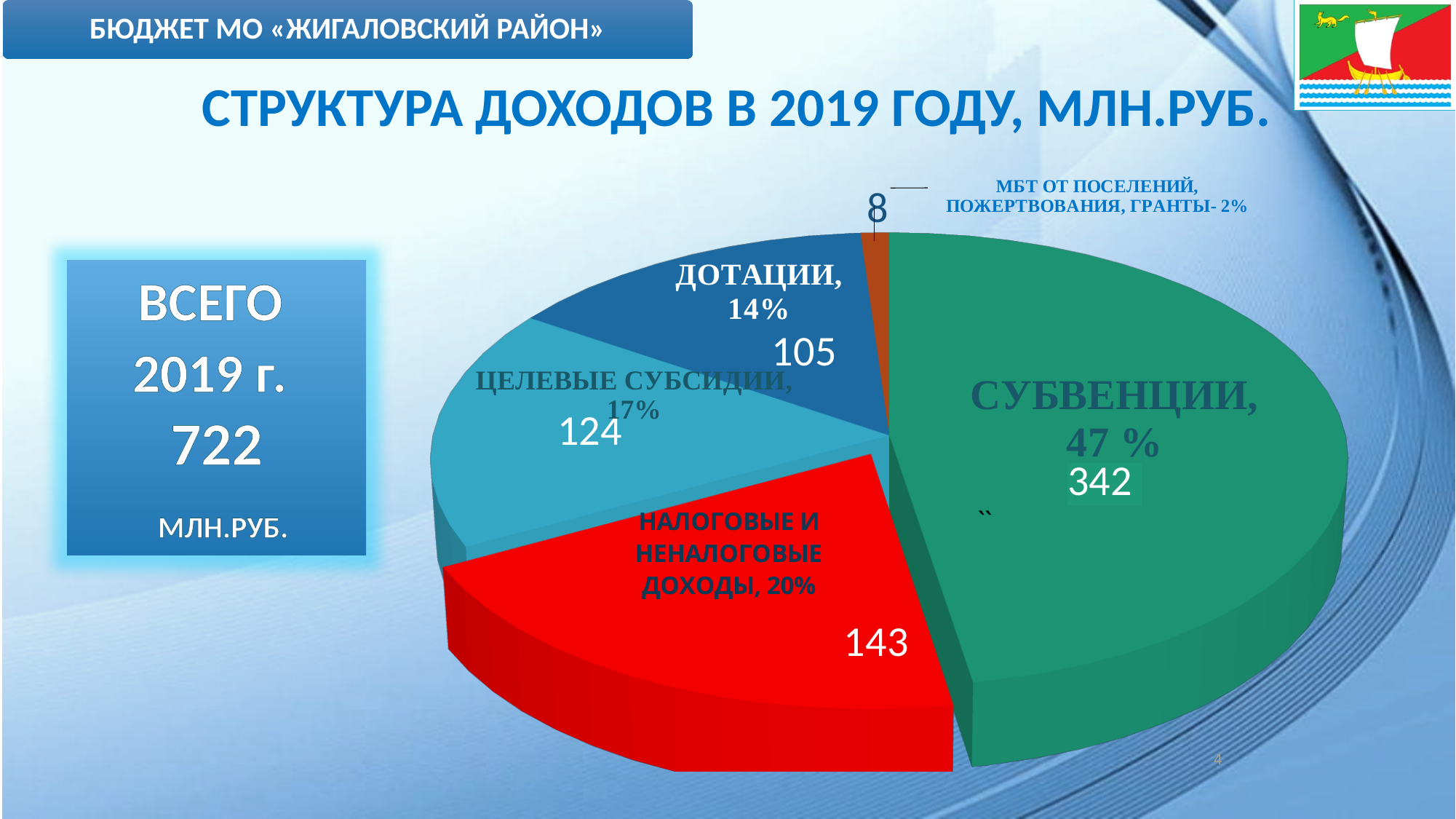
Which category has the smallest slice in the pie chart? МБТ ОТ ПОСЕЛЕНИЙ, ПОЖЕРТВОВАНИЯ, ГРАНТЫ What kind of chart is shown on the slide? pie chart What share of the pie does «СУБВЕНЦИИ» represent? 47 % Which category has the largest slice in the pie chart? СУБВЕНЦИИ What is the value for «СУБВЕНЦИИ» in the pie chart? 342 What is the difference between the values for «СУБВЕНЦИИ» and «НАЛОГОВЫЕ И НЕНАЛОГОВЫЕ ДОХОДЫ»? 199 How many slices does the pie chart have? 5 What is the value for «ДОТАЦИИ» in the pie chart? 105 Which is larger, the value for «ЦЕЛЕВЫЕ СУБСИДИИ» or the value for «ДОТАЦИИ»? ЦЕЛЕВЫЕ СУБСИДИИ What is the value for «НАЛОГОВЫЕ И НЕНАЛОГОВЫЕ ДОХОДЫ» in the pie chart? 143 What share of the pie does «МБТ ОТ ПОСЕЛЕНИЙ, ПОЖЕРТВОВАНИЯ, ГРАНТЫ» represent? 2% What is the value for «ЦЕЛЕВЫЕ СУБСИДИИ» in the pie chart? 124